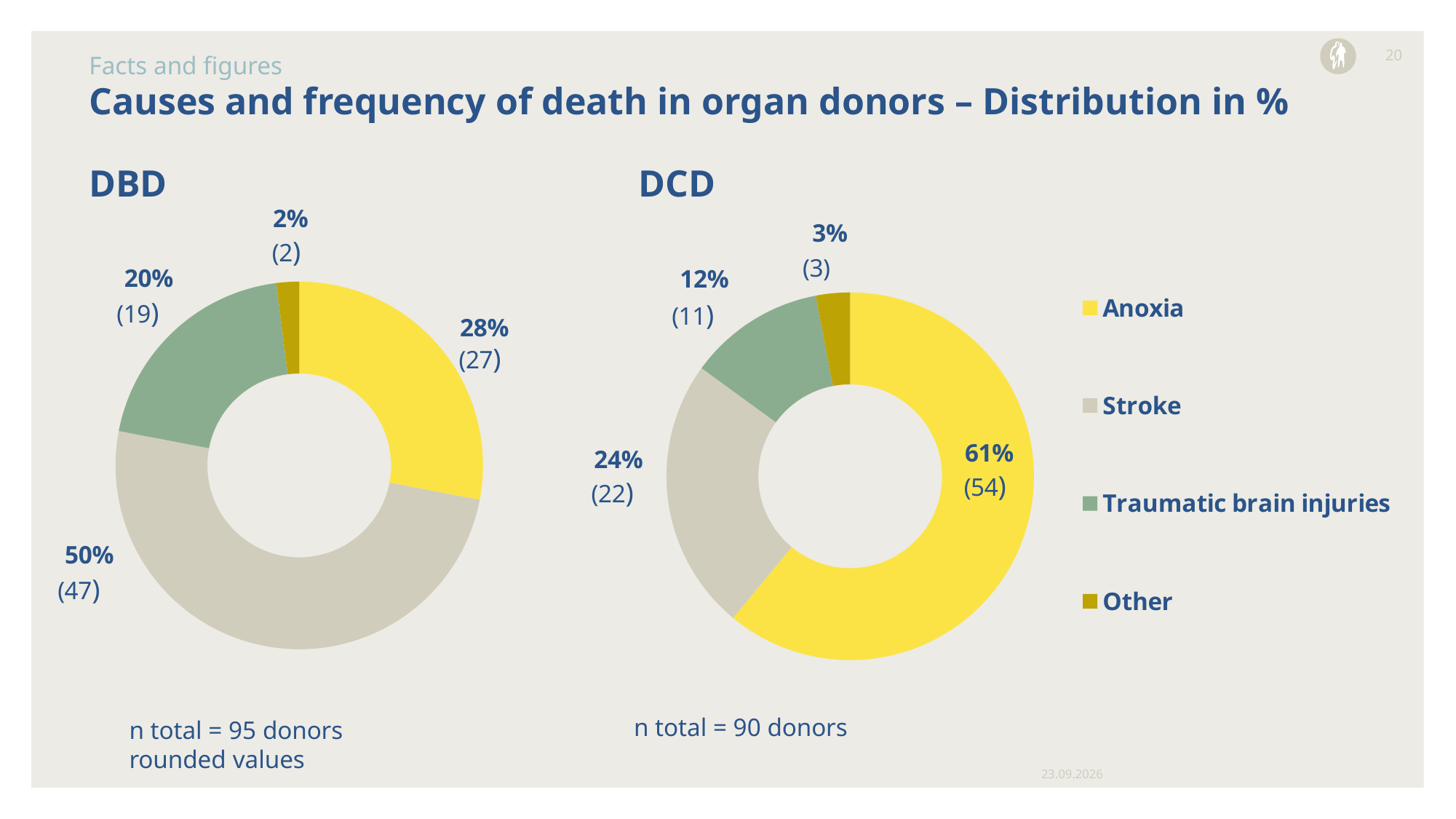
In the DCD chart, how many donors are in the Other category? 3 What kind of chart is used on this slide? Pie (doughnut) chart Which colour represents stroke in the legend? Light grey In the DBD chart, which cause of death has the largest share? Stroke In the DBD chart, which is larger: the share for anoxia or the share for traumatic brain injuries? Anoxia In the DBD chart, how many donors died from traumatic brain injuries? 19 In the DBD chart, what percentage of donors died from stroke? 50% In the DCD chart, which cause of death has the smallest share? Other What is the total number of donors in the DCD chart? 90 donors In the DCD chart, what is the difference in percentage points between anoxia and stroke? 37 How many categories does each chart show? 4 In the DCD chart, what percentage of donors died from anoxia? 61%